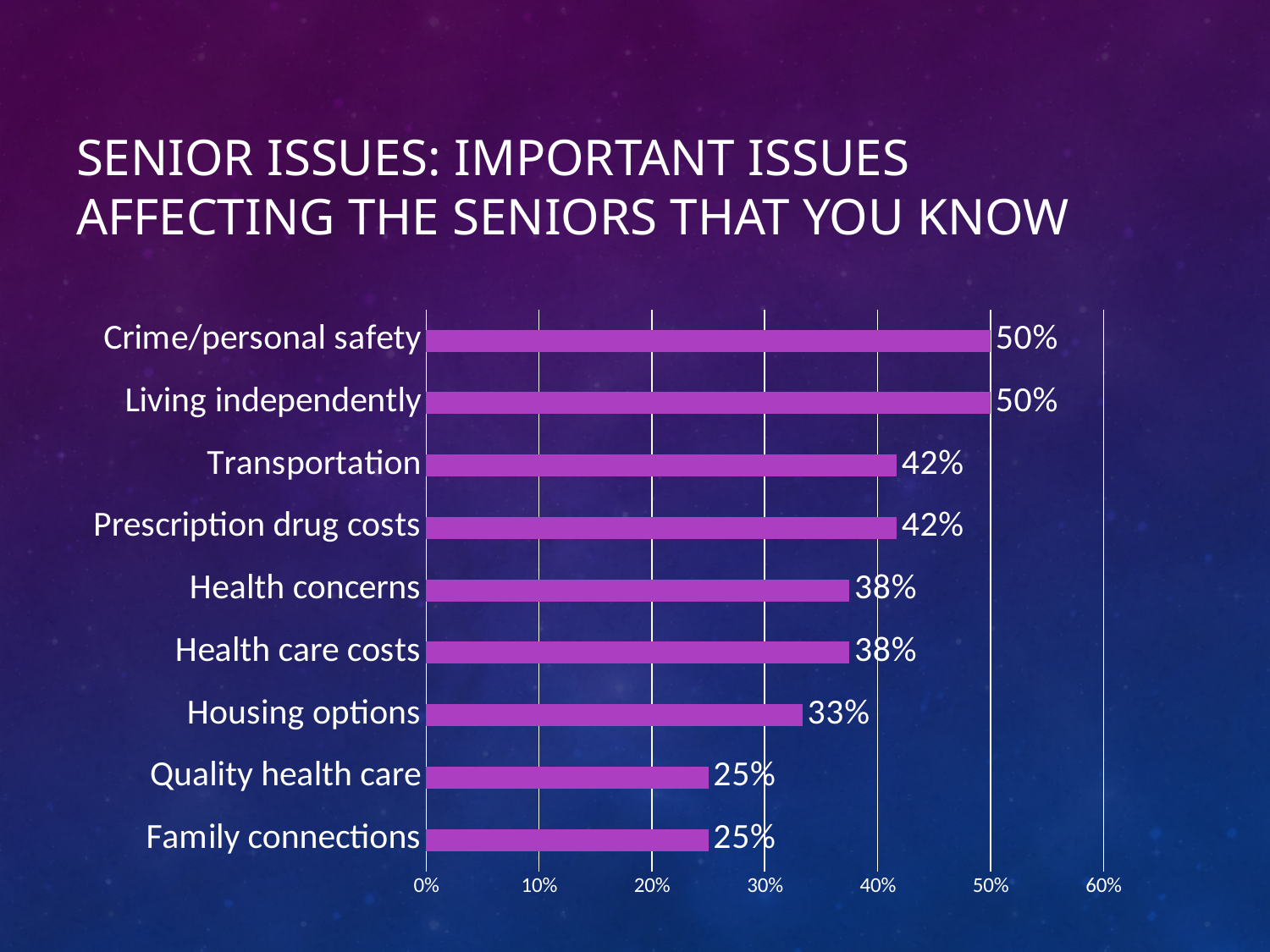
What is the difference between the values for Crime/personal safety and Housing options? 17% What is the title of the chart on the slide? Senior Issues: Important Issues Affecting the Seniors That You Know How many categories are shown in the chart? 9 Which categories have the lowest value? Quality health care and Family connections Which categories have the highest value? Crime/personal safety and Living independently What is the value for Transportation? 42% What is the difference between the values for Prescription drug costs and Quality health care? 17% What is the value for Health care costs? 38% Which is larger, the value for Health concerns or the value for Housing options? Health concerns What is the value for Family connections? 25% What kind of chart is shown on the slide? Bar chart What is the value for Housing options? 33%